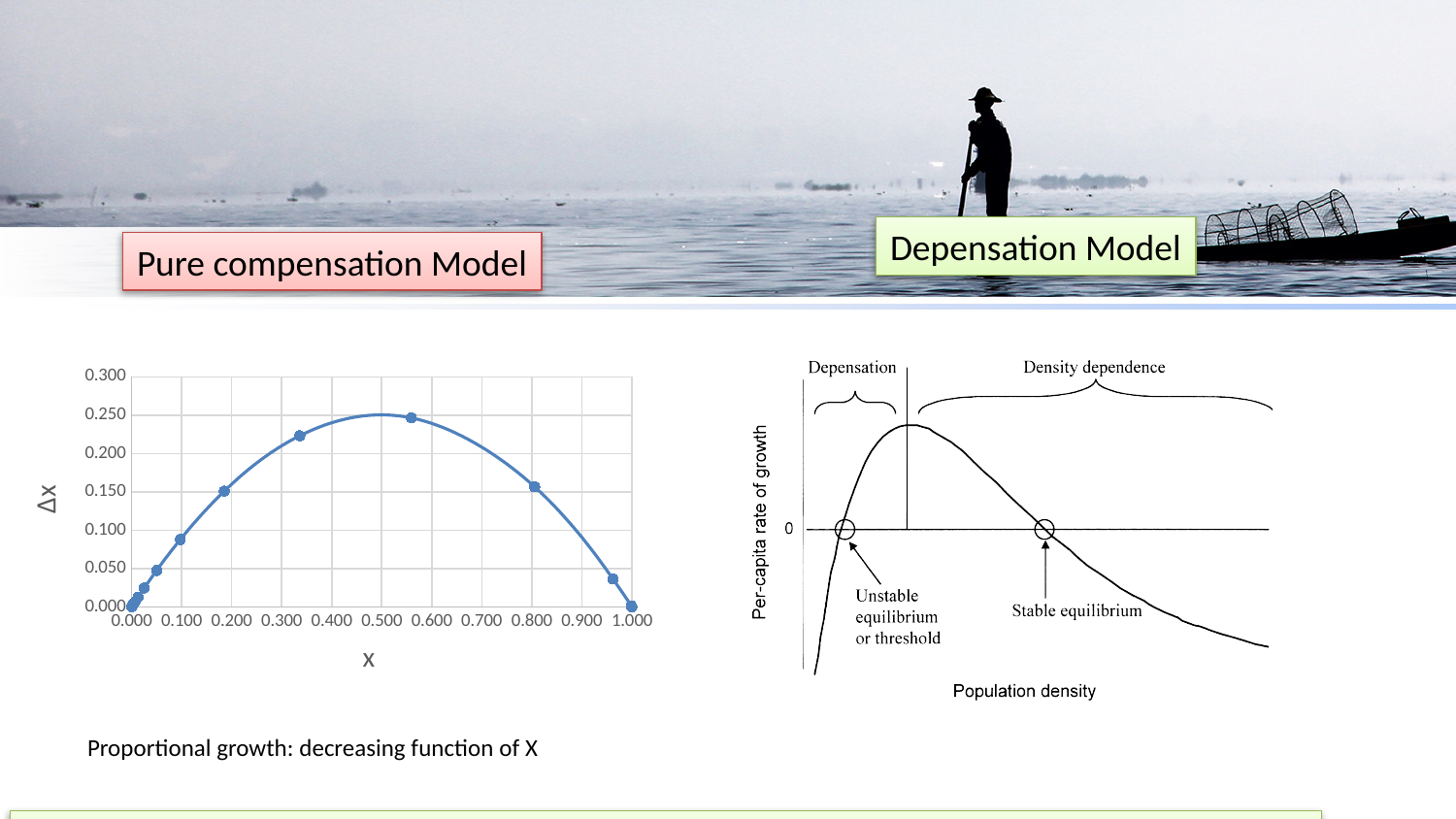
In the right chart (Depensation Model), which equilibrium is labeled at the right-hand circled point? Stable equilibrium In the left chart (Pure compensation Model), how does Δx change as x increases from 0.000 to 1.000? It rises to a peak near x = 0.500 and then falls back to 0 In the left chart (Pure compensation Model), what kind of chart is shown? Line chart with markers In the left chart (Pure compensation Model), is the value of Δx at the point near x = 0.550 greater or less than 0.200? greater In the left chart (Pure compensation Model), what is the label on the vertical axis? Δx In the right chart (Depensation Model), what is the label on the horizontal axis? Population density In the left chart (Pure compensation Model), is the value of Δx at the point near x = 0.800 greater or less than 0.200? less In the left chart (Pure compensation Model), which is larger: Δx at the point near x = 0.330 or Δx at the point near x = 0.800? x = 0.330 In the right chart (Depensation Model), how many equilibrium points are circled on the zero line? 2 In the left chart (Pure compensation Model), is the value of Δx at the point near x = 0.950 greater or less than 0.050? less In the left chart (Pure compensation Model), what is the highest value shown on the vertical axis? 0.300